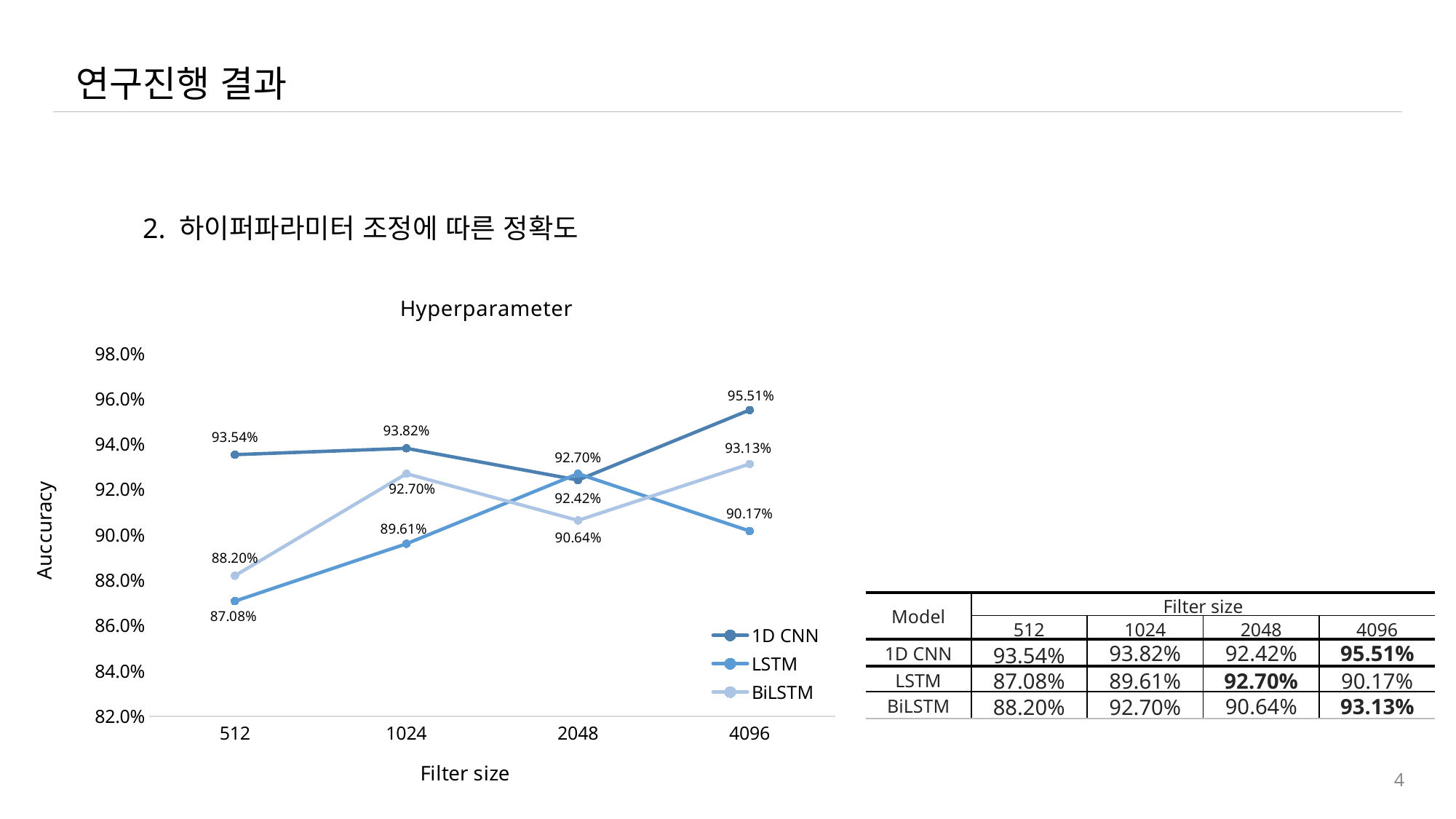
Which is larger at filter size 1024: the accuracy of LSTM or BiLSTM? BiLSTM What is the accuracy of LSTM at filter size 512? 87.08% Does the LSTM accuracy rise or fall from filter size 512 to 2048? rise What type of chart is shown on the slide? line chart How many filter sizes are plotted along the x axis? 4 What is the accuracy of 1D CNN at filter size 4096? 95.51% What is the title of the chart? Hyperparameter What is the accuracy of BiLSTM at filter size 2048? 90.64% How many series does the chart legend list? 3 What is the difference between the 1D CNN accuracy at 4096 and the LSTM accuracy at 4096? 5.34% At which filter size does 1D CNN reach its highest accuracy? 4096 Which series has the lowest accuracy at filter size 512? LSTM